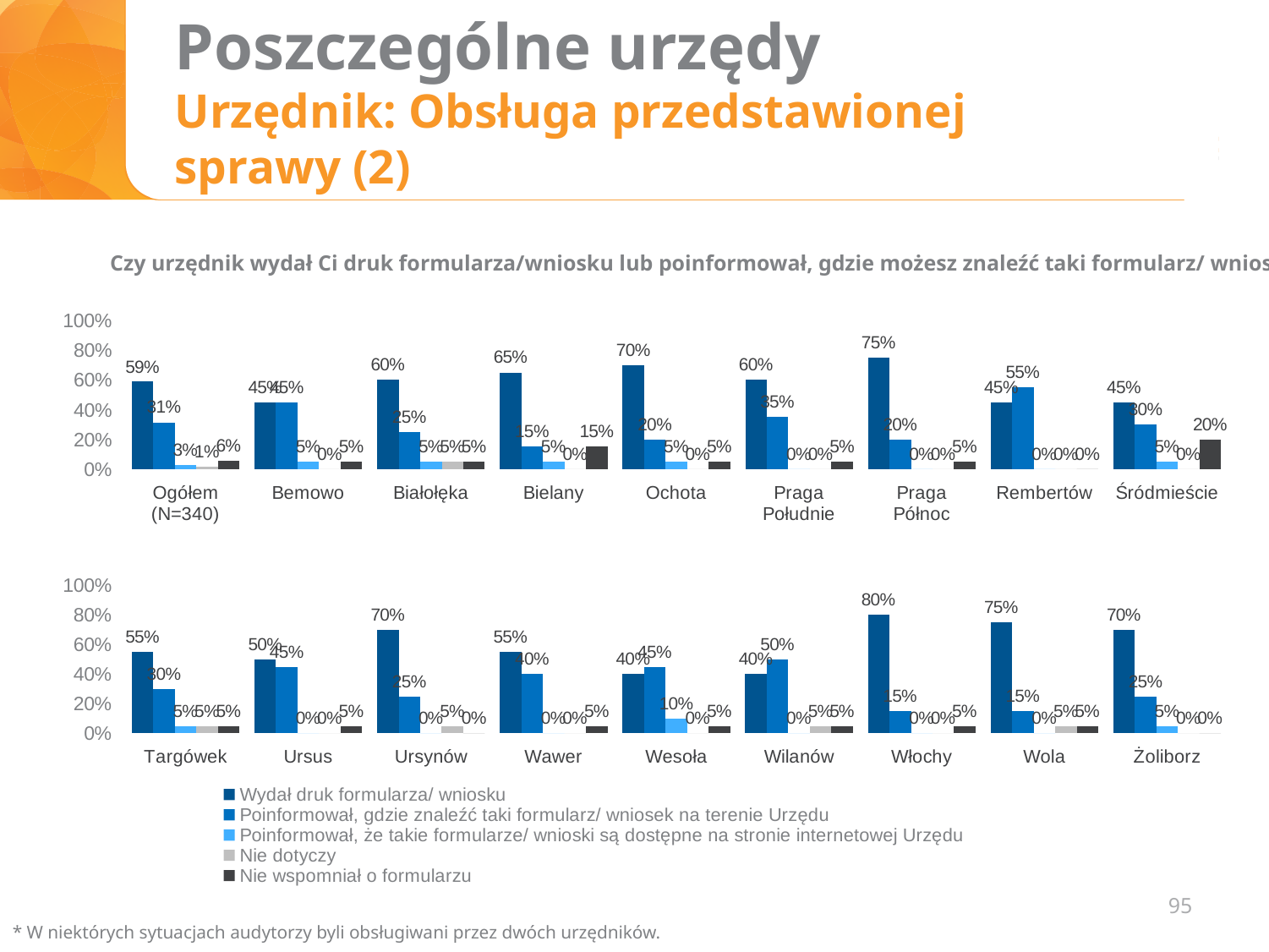
In the top chart, what is the value of 'Nie wspomniał o formularzu' for Bielany? 15% In the top chart, for Rembertów, which is larger: 'Wydał druk formularza/ wniosku' or 'Poinformował, gdzie znaleźć taki formularz/ wniosek na terenie Urzędu'? Poinformował, gdzie znaleźć taki formularz/ wniosek na terenie Urzędu What kind of chart is shown on the slide? Bar chart In the bottom chart, what is the value of 'Poinformował, gdzie znaleźć taki formularz/ wniosek na terenie Urzędu' for Wilanów? 50% In the top chart, what is the value of 'Wydał druk formularza/ wniosku' for Ogółem (N=340)? 59% In the top chart, which category has the highest value for 'Wydał druk formularza/ wniosku'? Praga Północ In the bottom chart, what is the value of 'Wydał druk formularza/ wniosku' for Wola? 75% How many categories are shown on the x axis of the bottom chart? 9 How many series does the legend list? 5 In the top chart, what is the difference between the 'Wydał druk formularza/ wniosku' values for Praga Północ and Ogółem (N=340)? 16 percentage points In the top chart, what is the value of 'Nie wspomniał o formularzu' for Śródmieście? 20% In the bottom chart, which category has the highest value for 'Wydał druk formularza/ wniosku'? Włochy